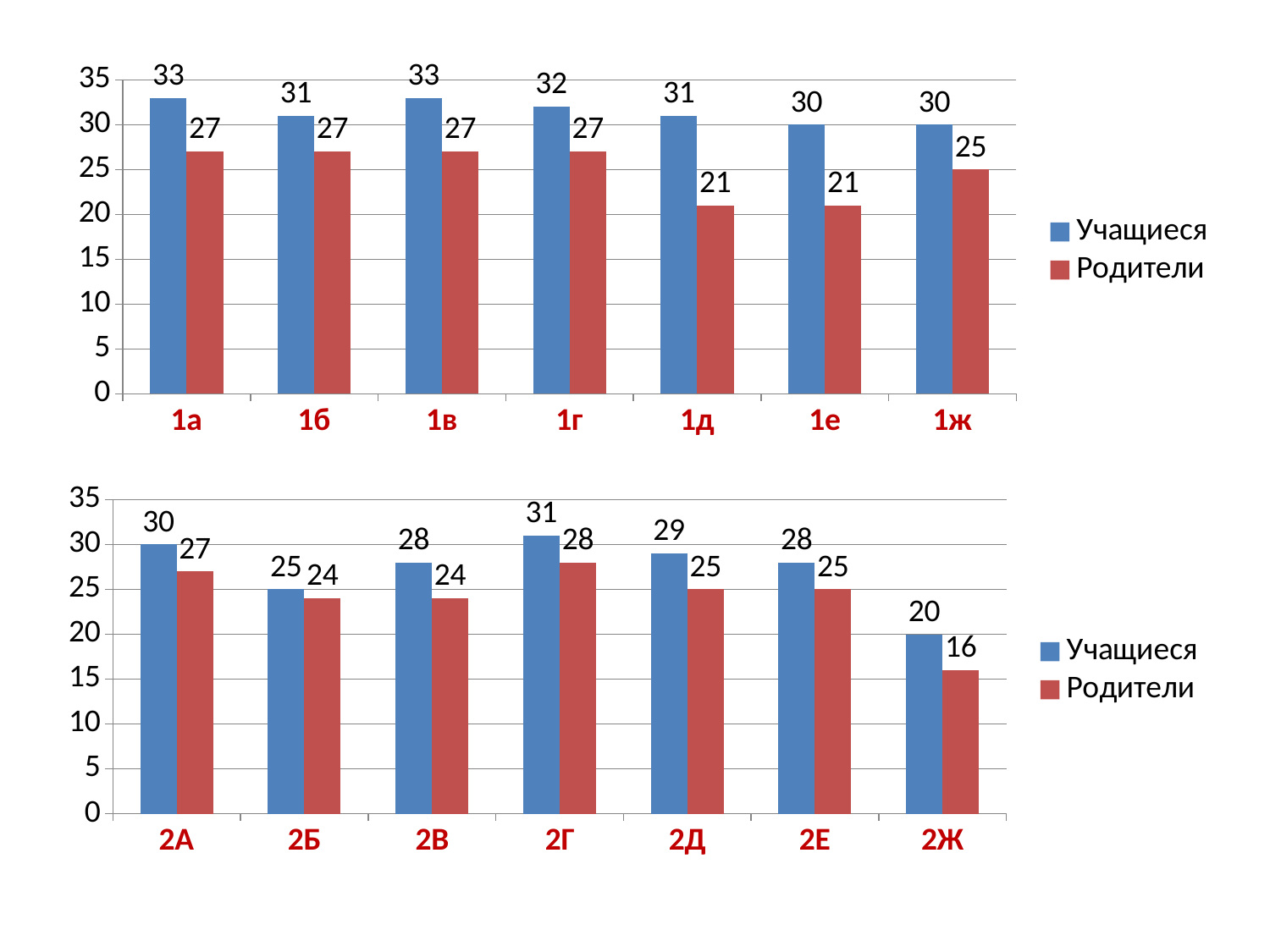
In the bottom chart, what is the value for Родители in category 2Б? 24 In the top chart, how many series does the legend list? 2 In the bottom chart, which category has the highest value for Учащиеся? 2Г In the top chart, which series is shown in red? Родители In the top chart, what is the value for Родители in category 1ж? 25 In the bottom chart, what is the difference between Учащиеся and Родители in category 2Ж? 4 In the bottom chart, which category has the lowest value for Родители? 2Ж In the top chart, how many categories are shown on the x axis? 7 In the top chart, what is the difference between Учащиеся and Родители in category 1д? 10 In the top chart, what is the value for Учащиеся in category 1г? 32 In the bottom chart, which is larger: Учащиеся in 2А or Учащиеся in 2Д? Учащиеся in 2А What kind of chart is the bottom chart? Bar chart